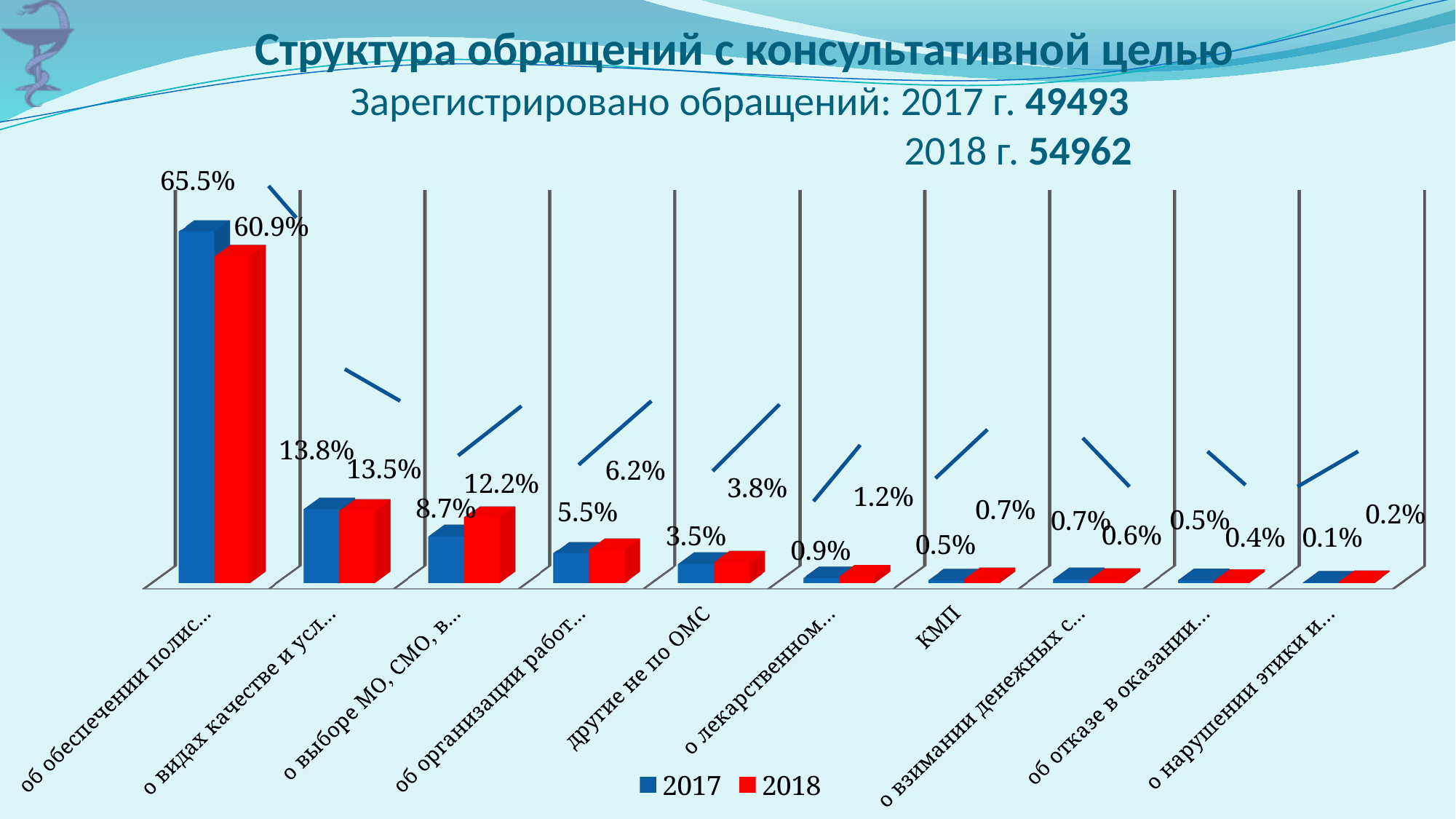
How many categories are shown on the x axis of the chart? 10 What kind of chart is shown on the slide? Bar chart Which category has the highest 2017 value? об обеспечении полис… (the leftmost category) What is the 2017 value for the category 'КМП'? 0.5% What is the 2017 value for the category 'другие не по ОМС'? 3.5% Which category has the lowest 2017 value? о нарушении этики и… (the rightmost category) For the category 'КМП', which year has the larger value, 2017 or 2018? 2018 What is the difference between the 2017 and 2018 values for the leftmost category (65.5% and 60.9%)? 4.6 percentage points What is the 2018 value for the category 'другие не по ОМС'? 3.8% What is the 2018 value for the category 'КМП'? 0.7% How many series does the legend list? 2 What are the two entries in the chart legend? 2017 and 2018